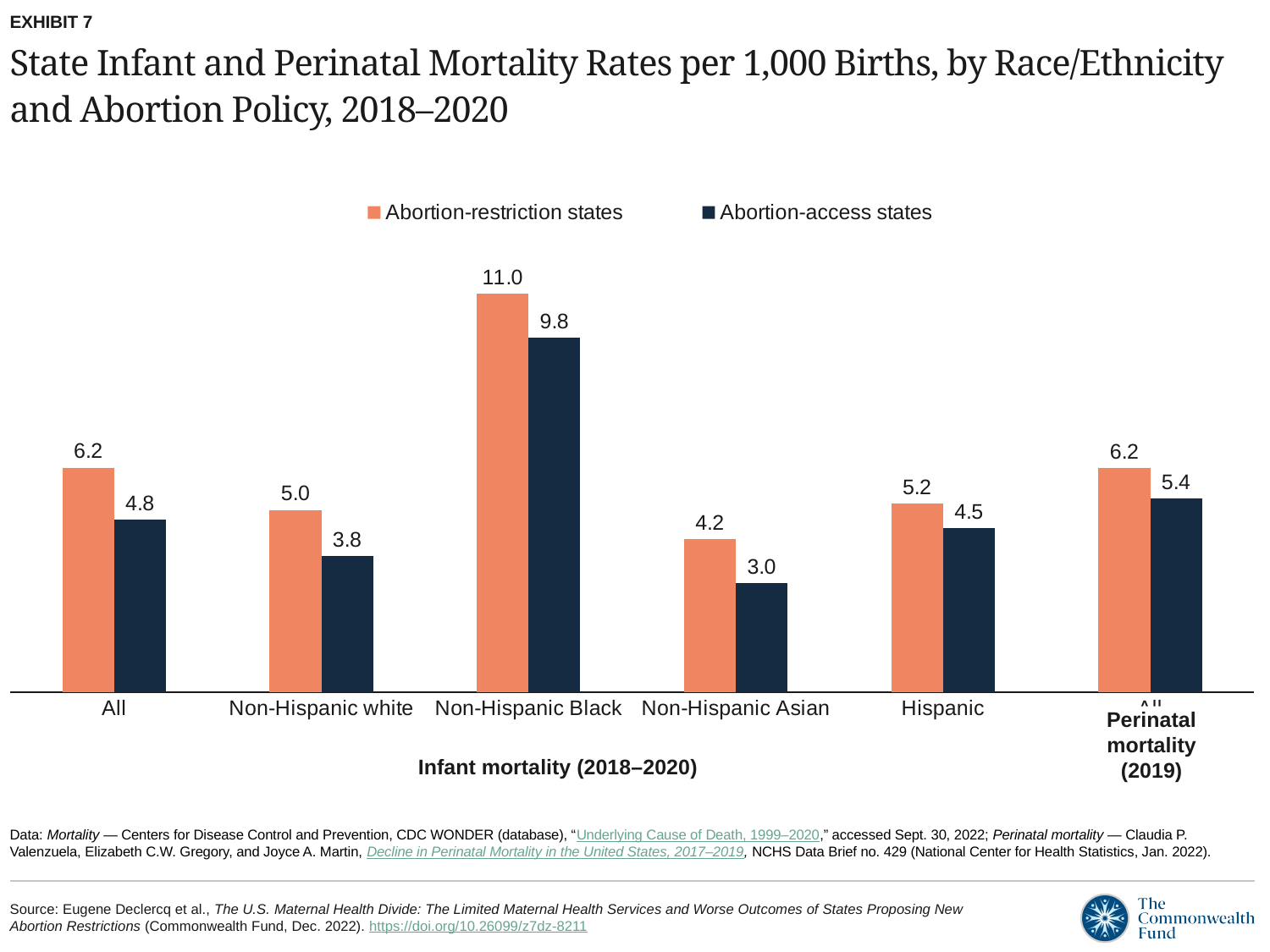
What is the perinatal mortality (2019) rate for abortion-access states? 5.4 Which is larger: the abortion-access rate for Hispanic or the abortion-access rate for Non-Hispanic white? Hispanic What is the infant mortality rate for Non-Hispanic Asian in abortion-access states? 3.0 What is the difference between the abortion-restriction and abortion-access infant mortality rates for the All category? 1.4 How many series does the legend list? 2 What is the difference between the abortion-restriction and abortion-access rates for Non-Hispanic white? 1.2 Which race/ethnicity category has the highest infant mortality rate in abortion-access states? Non-Hispanic Black What kind of chart is shown on the slide? Bar chart Which series is shown in orange in the legend? Abortion-restriction states What is the infant mortality rate for Non-Hispanic Black in abortion-restriction states? 11.0 Which race/ethnicity category has the lowest infant mortality rate in abortion-restriction states? Non-Hispanic Asian What is the value for Hispanic in abortion-restriction states? 5.2